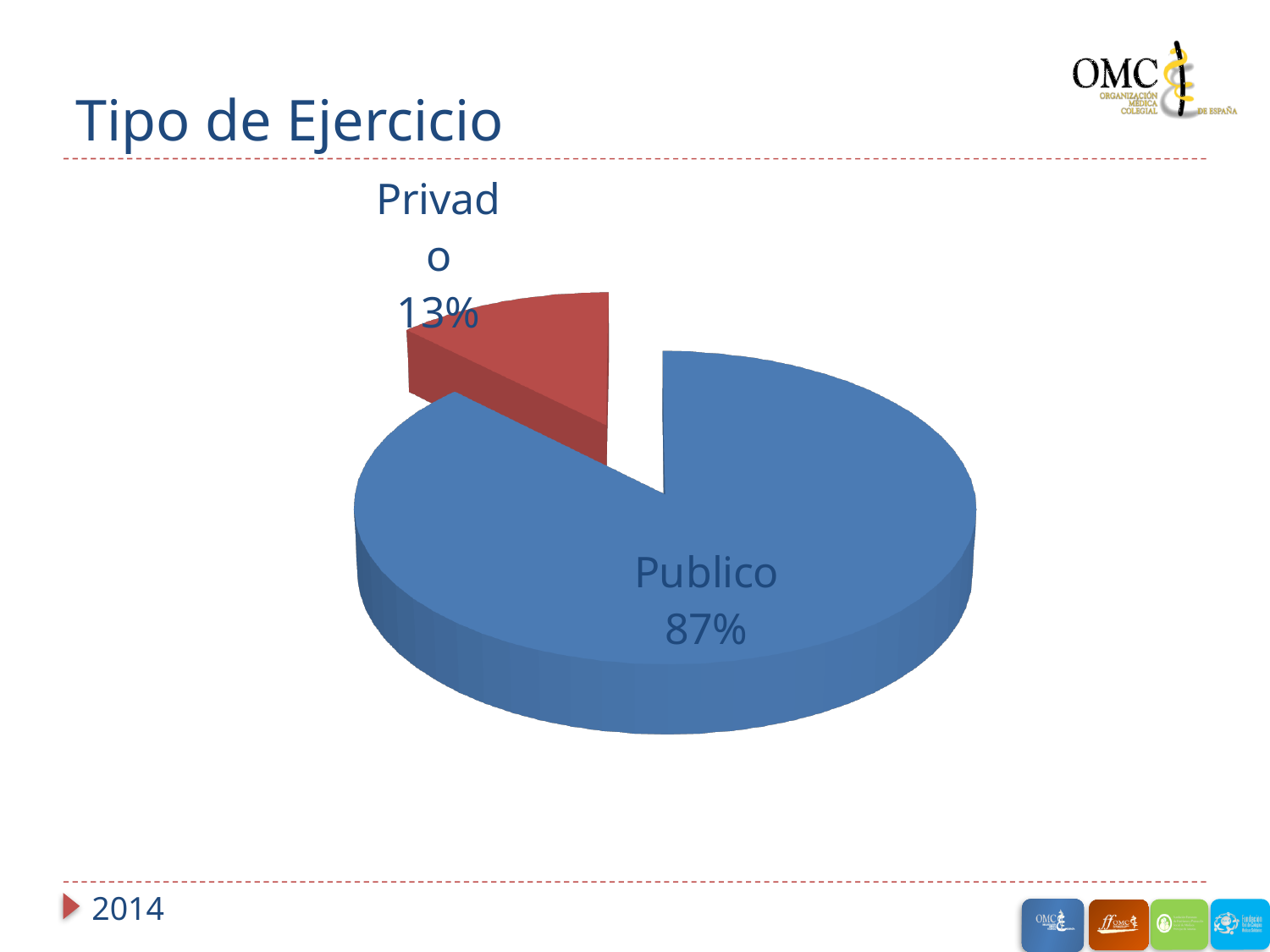
Which category has the largest slice of the pie? Publico Which is larger, the Publico slice or the Privado slice? Publico What year is shown at the bottom of the slide? 2014 What share of the pie does Publico represent? 87% How many categories does the pie chart show? 2 What colour is the Privado slice? Red What is the title of the slide? Tipo de Ejercicio Is the value for Publico greater or less than 50%? greater Which category has the smallest slice of the pie? Privado What is the difference in percentage points between Publico and Privado? 74 What share of the pie does Privado represent? 13% What kind of chart is shown on the slide? Pie chart